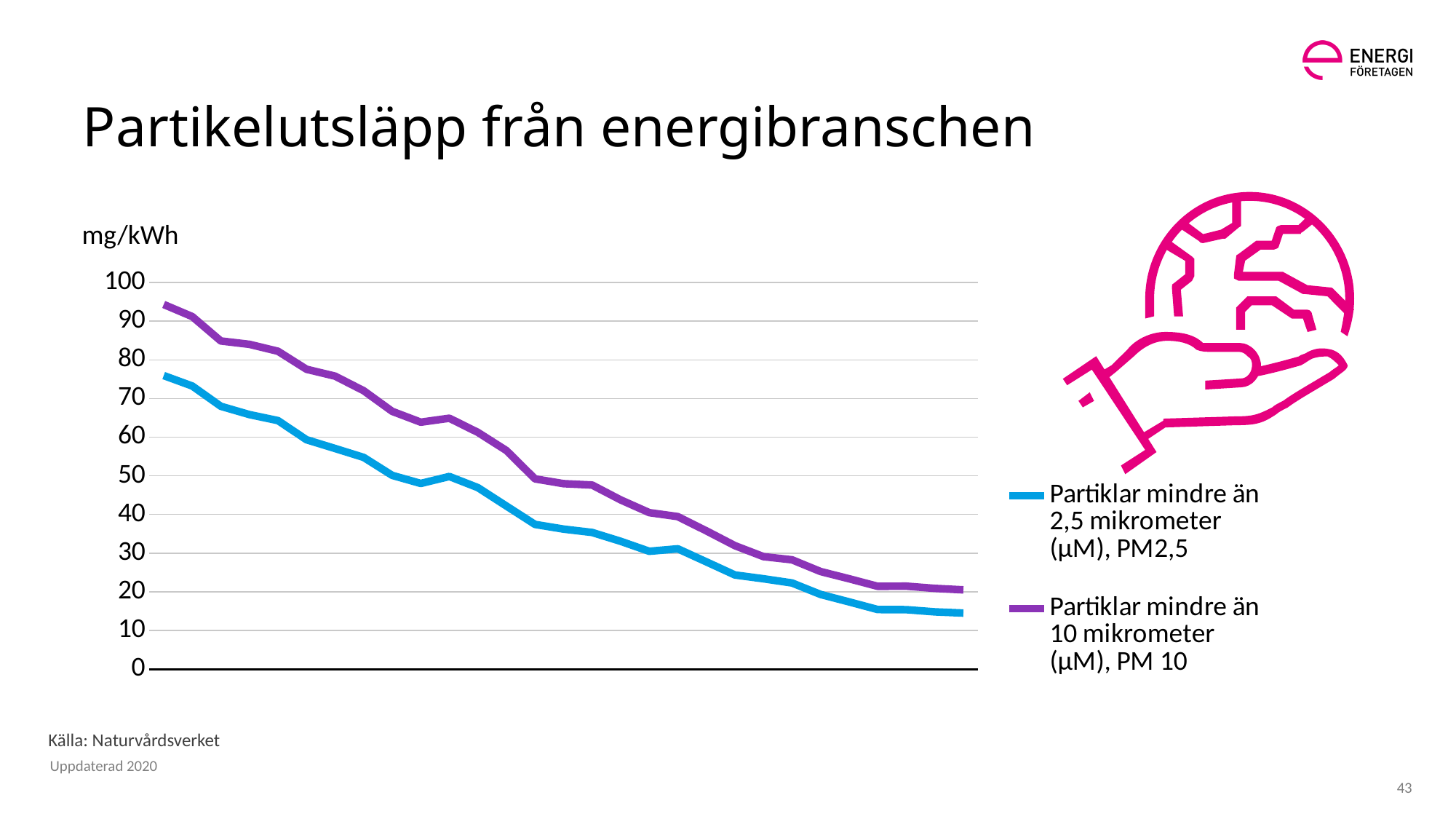
Do the values for 'Partiklar mindre än 2,5 mikrometer (µM), PM2,5' rise or fall along the x axis? fall Which series has the higher values throughout the chart, PM 10 or PM2,5? PM 10 Is the first value of the PM 10 series greater or less than 90? greater Is the last value of the PM 10 series greater or less than 30? less What kind of chart is shown on the slide? line chart Do the values for 'Partiklar mindre än 10 mikrometer (µM), PM 10' rise or fall along the x axis? fall Is the first value of the PM2,5 series greater or less than 70? greater What unit is shown on the y axis of the chart? mg/kWh What colour is the line for 'Partiklar mindre än 10 mikrometer (µM), PM 10'? purple How many series does the legend list? 2